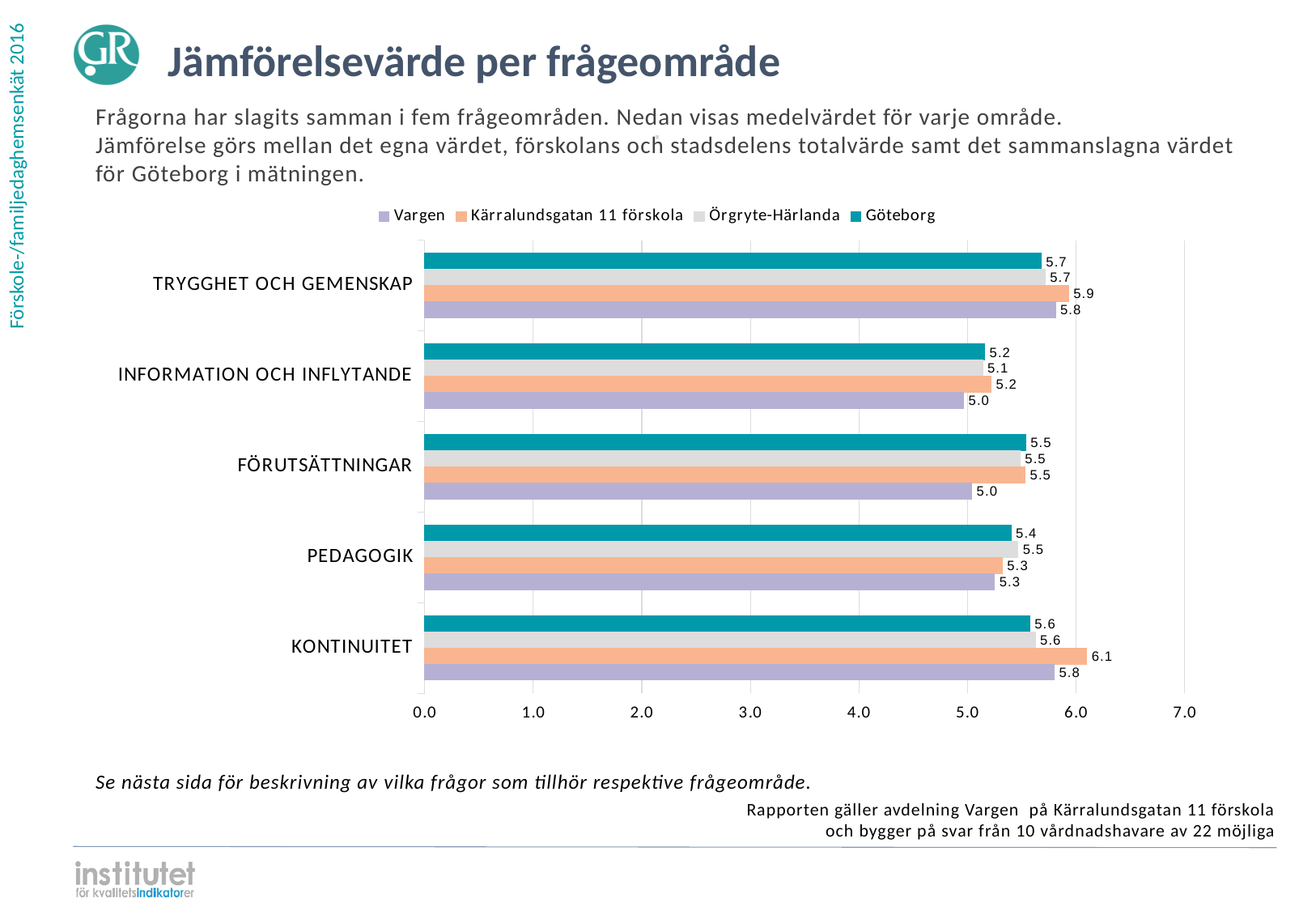
What is the value for Göteborg in the PEDAGOGIK category? 5.4 What is the difference between the Kärralundsgatan 11 förskola value and the Vargen value in the KONTINUITET category? 0.3 What kind of chart is shown on the slide? Bar chart How many question areas (categories) are shown on the chart? 5 In which category does Kärralundsgatan 11 förskola have its highest value? KONTINUITET What is the value for Kärralundsgatan 11 förskola in the TRYGGHET OCH GEMENSKAP category? 5.9 What is the title of the slide? Jämförelsevärde per frågeområde What is the value for Vargen in the KONTINUITET category? 5.8 What is the value for Örgryte-Härlanda in the INFORMATION OCH INFLYTANDE category? 5.1 How many series does the legend list? 4 In which categories does Vargen have its lowest value of 5.0? INFORMATION OCH INFLYTANDE and FÖRUTSÄTTNINGAR In the FÖRUTSÄTTNINGAR category, which is larger: the value for Göteborg or the value for Vargen? Göteborg